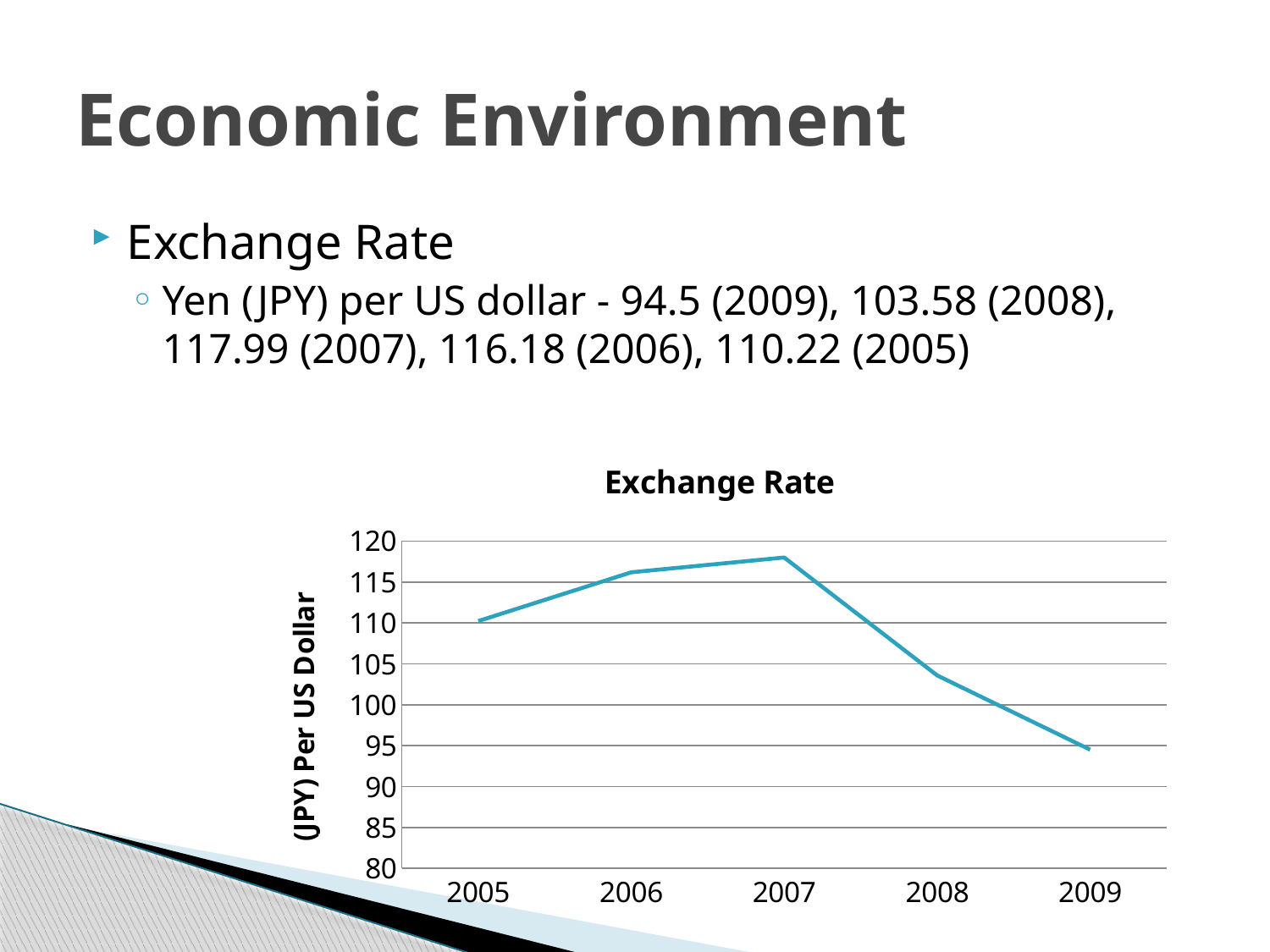
Which year has a higher exchange rate, 2006 or 2008? 2006 What is the exchange rate (JPY per US dollar) for 2005? 110.22 What type of chart is the Exchange Rate chart? line chart What is the exchange rate (JPY per US dollar) for 2009? 94.5 Which year has the highest exchange rate in the chart? 2007 Which year has the lowest exchange rate in the chart? 2009 What is the exchange rate (JPY per US dollar) for 2007? 117.99 What is the difference between the 2008 and 2009 exchange rates? 9.08 What is the label on the vertical axis of the chart? (JPY) Per US Dollar Does the exchange rate rise or fall from 2007 to 2009? fall How many years are plotted on the x axis of the Exchange Rate chart? 5 Is the value for 2008 greater or less than 100? greater